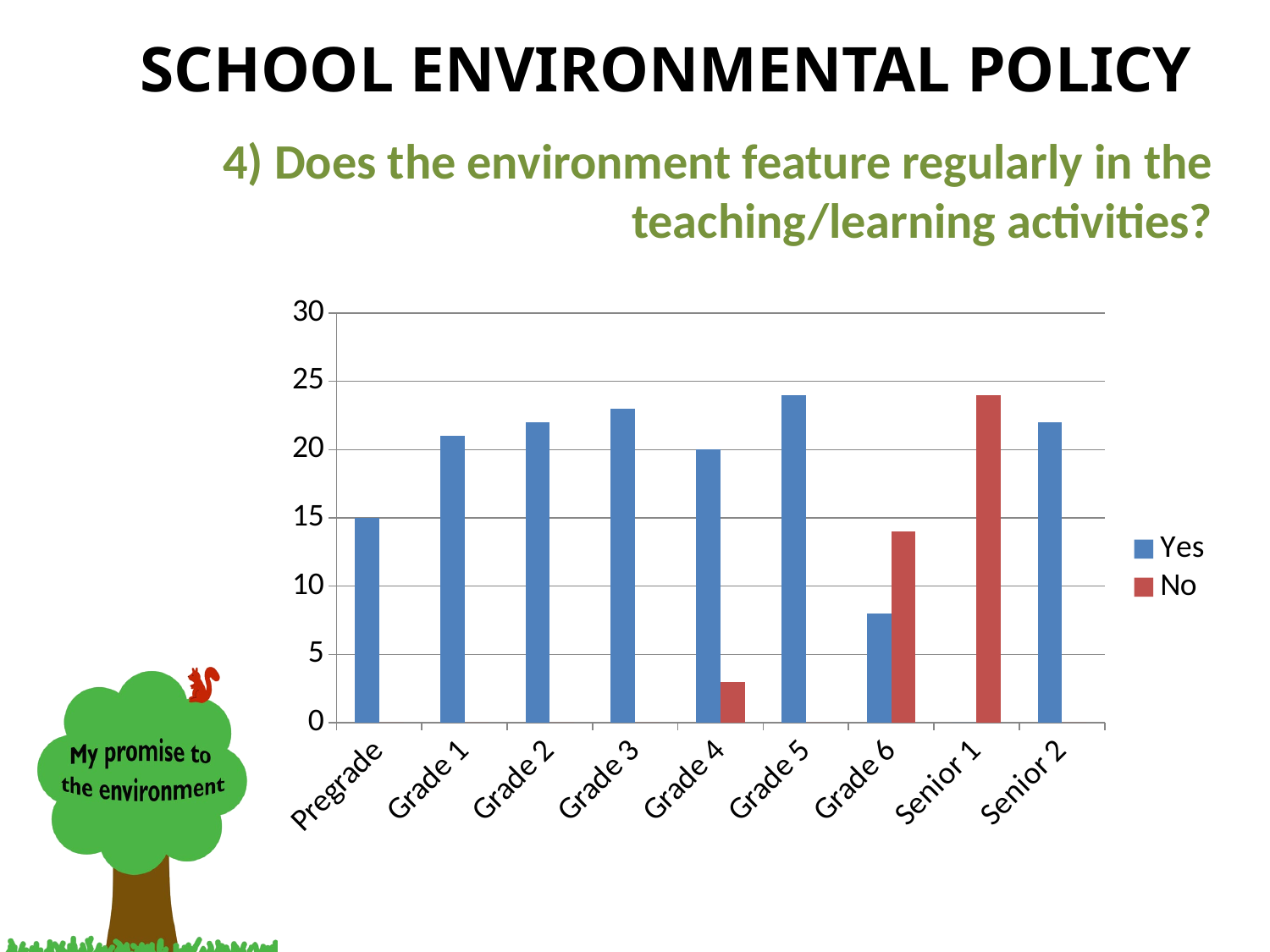
What kind of chart is shown on the slide? bar chart What is the Yes value for Pregrade? 15 How many grade categories are shown on the x axis? 9 For Grade 4, which is larger, the Yes value or the No value? Yes How many series does the legend list? 2 Is the No value for Senior 1 greater or less than 20? greater What is the Yes value for Grade 4? 20 For Grade 6, which is larger, the Yes value or the No value? No Is the No value for Grade 4 greater or less than 5? less Is the Yes value for Grade 5 greater or less than 20? greater Which category has the lowest Yes value? Senior 1 Which colour represents the No series in the legend? red